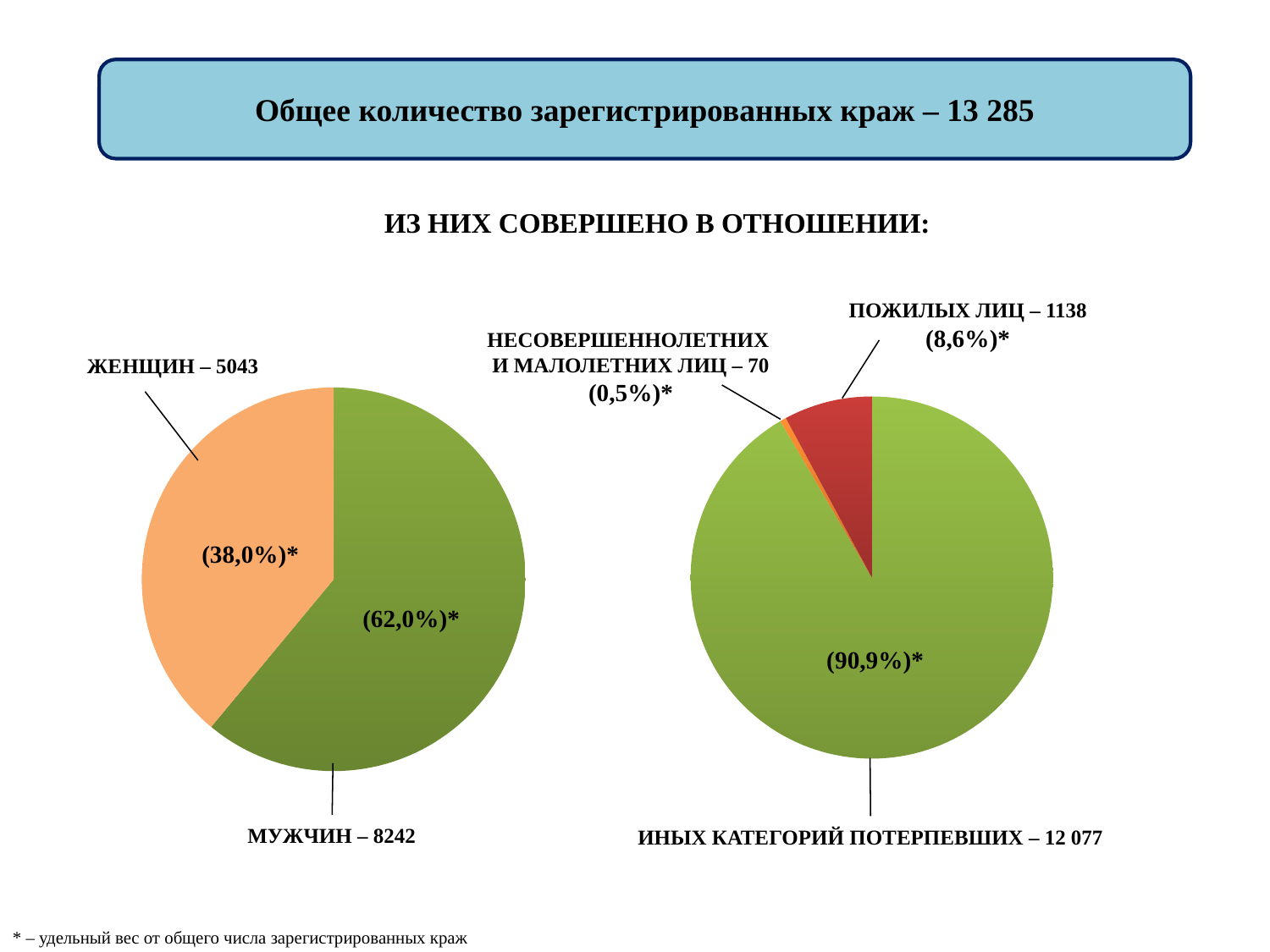
In the left pie chart, which category has the larger slice, ЖЕНЩИН or МУЖЧИН? МУЖЧИН How many slices does the right pie chart have? 3 What total number of registered thefts is stated in the header box of the slide? 13 285 In the left pie chart, how many thefts were committed against women (ЖЕНЩИН)? 5043 What type of chart is shown on the left of the slide? Pie chart In the left pie chart, what share of thefts were committed against women (ЖЕНЩИН)? 38,0% In the right pie chart, what share of thefts falls on other categories of victims (ИНЫХ КАТЕГОРИЙ ПОТЕРПЕВШИХ)? 90,9% In the right pie chart, how many thefts were committed against elderly persons (ПОЖИЛЫХ ЛИЦ)? 1138 In the left pie chart, what is the difference between the number of thefts against men and against women? 3199 In the right pie chart, which category has the smallest slice? НЕСОВЕРШЕННОЛЕТНИХ И МАЛОЛЕТНИХ ЛИЦ In the right pie chart, how many thefts were committed against minors (НЕСОВЕРШЕННОЛЕТНИХ И МАЛОЛЕТНИХ ЛИЦ)? 70 In the left pie chart, how many thefts were committed against men (МУЖЧИН)? 8242